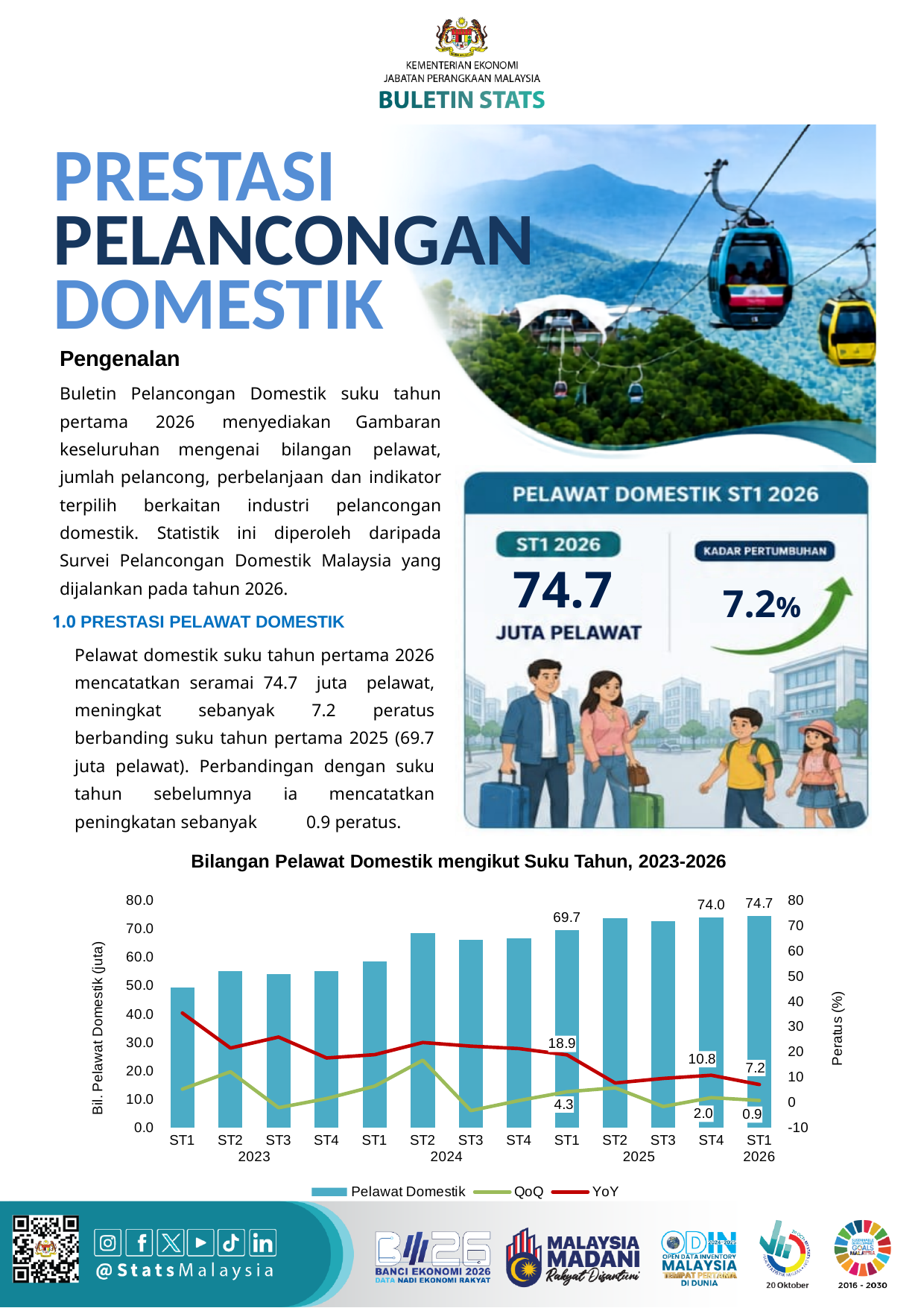
What is the difference in Pelawat Domestik between ST1 2026 and ST1 2025? 5.0 Which quarter has the highest number of Pelawat Domestik? ST1 2026 Which is larger, the Pelawat Domestik value for ST4 2025 or ST1 2025? ST4 2025 What is the difference between the YoY value for ST1 2025 and ST1 2026? 11.7 What is the YoY value for ST1 2025? 18.9 How many series does the legend list? 3 What is the QoQ value for ST4 2025? 2.0 How many quarters are shown on the x axis? 13 Which quarter has the lowest number of Pelawat Domestik? ST1 2023 Is the Pelawat Domestik value for ST2 2024 greater or less than 60.0? greater What is the value of Pelawat Domestik for ST1 2026? 74.7 Does the YoY line rise or fall from ST1 2025 to ST1 2026? fall